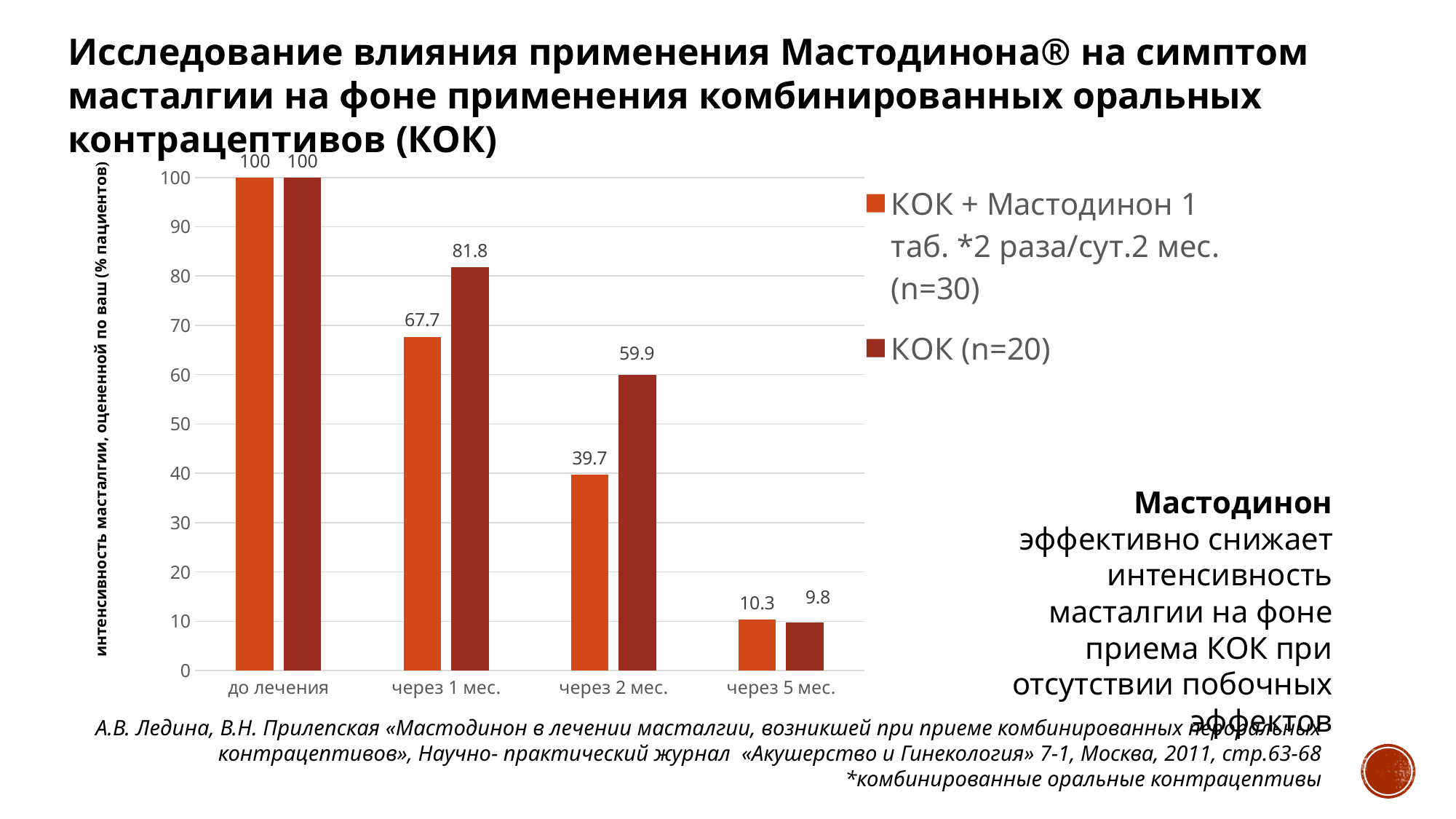
What is the value for the КОК (n=20) series at через 5 мес.? 9.8 Do the values of the КОК + Мастодинон series rise or fall from до лечения to через 5 мес.? fall At which category is the КОК (n=20) series highest? до лечения At через 1 мес., which series has the larger value: КОК + Мастодинон or КОК (n=20)? КОК (n=20) How many series does the legend list? 2 What is the value for the КОК (n=20) series at через 2 мес.? 59.9 At which category is the КОК + Мастодинон series lowest? через 5 мес. What is the value for the КОК + Мастодинон series at до лечения? 100 What is the value for the КОК + Мастодинон series at через 1 мес.? 67.7 What kind of chart is shown on the slide? bar chart How many categories are shown on the x axis? 4 What is the difference between the КОК (n=20) and КОК + Мастодинон values at через 2 мес.? 20.2